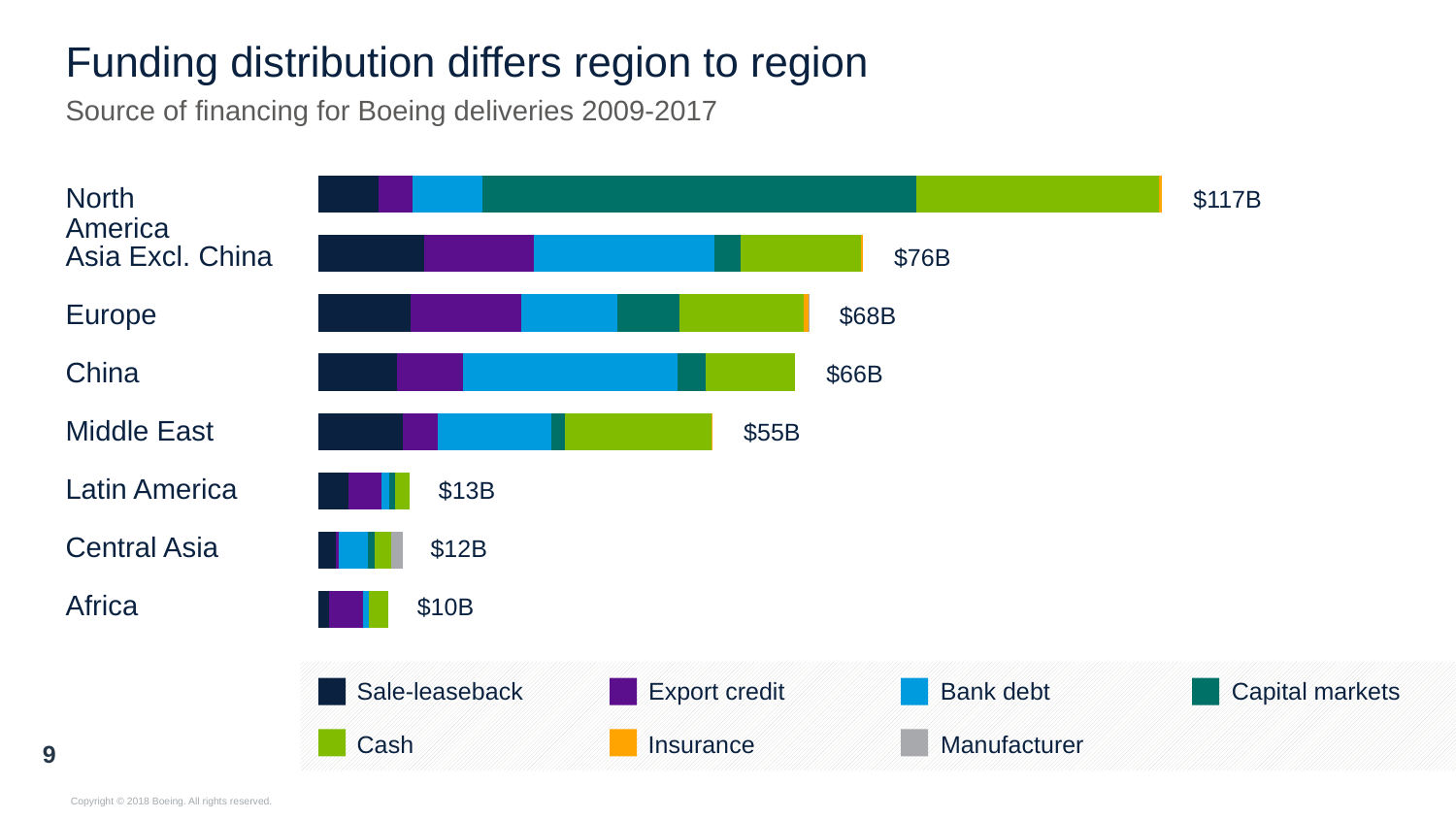
What is the total funding shown for Middle East? $55B How many regions are shown in the chart? 8 Which region has the highest total funding? North America Which region has the lowest total funding? Africa What kind of chart is shown on the slide? Stacked bar chart Which has a larger total, Latin America or Africa? Latin America What is the difference between the totals for North America and Asia Excl. China? $41B What is the difference between the totals for Europe and China? $2B How many financing sources does the legend list? 7 What is the total funding shown for North America? $117B What is the total funding shown for Central Asia? $12B Which financing source is shown in orange in the legend? Insurance